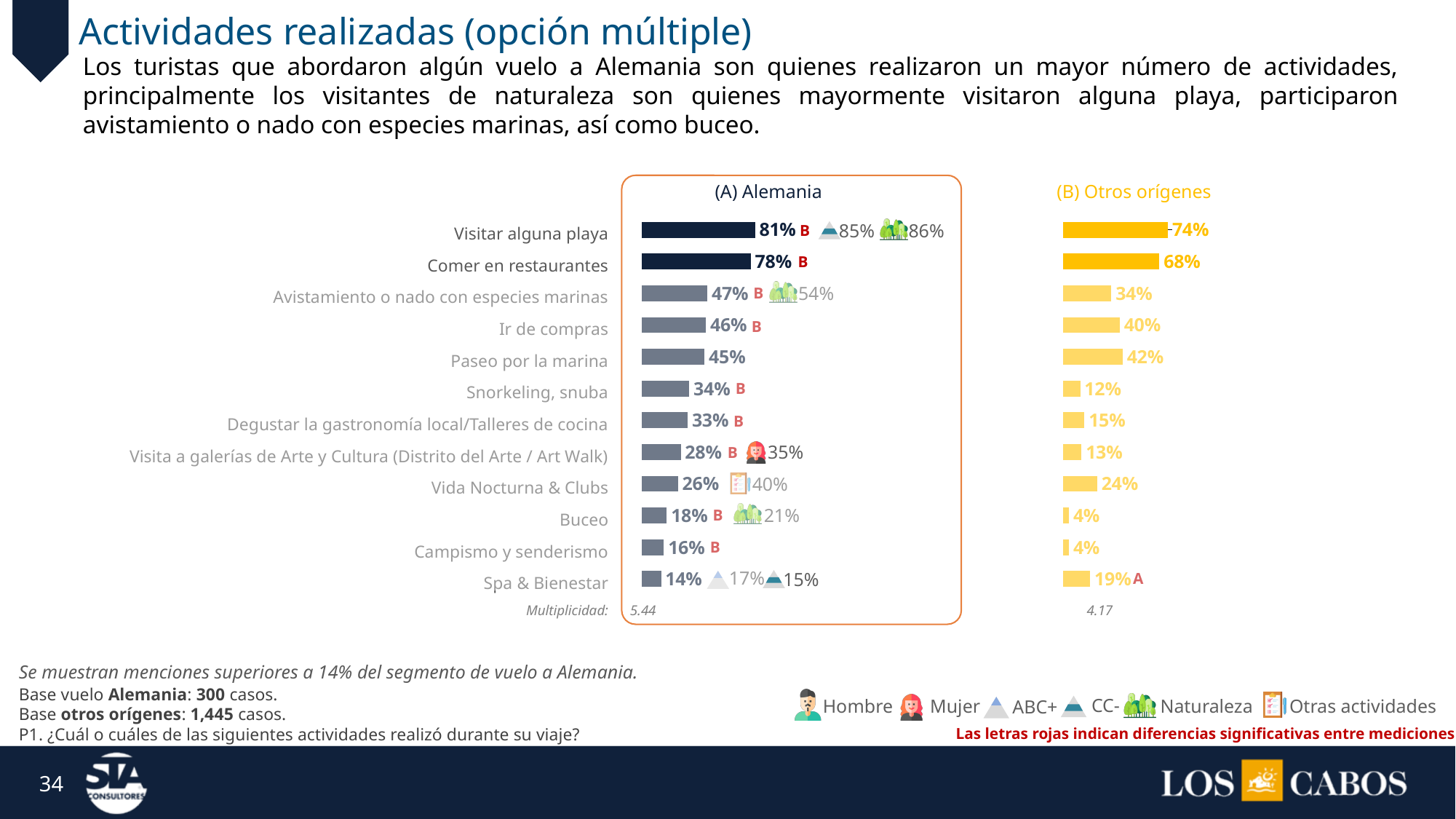
In the (B) Otros orígenes chart, which activity has the lowest percentage? Buceo and Campismo y senderismo (4%) In the (A) Alemania chart, which activity has the highest percentage? Visitar alguna playa What is the difference between the Alemania and Otros orígenes percentages for Snorkeling, snuba? 22 percentage points For Ir de compras, which is larger: the (A) Alemania value or the (B) Otros orígenes value? (A) Alemania In the (B) Otros orígenes chart, what percentage is shown for Comer en restaurantes? 68% How many activities are listed in the (A) Alemania chart? 12 What is the Multiplicidad value shown for (B) Otros orígenes? 4.17 In the (A) Alemania chart, what percentage is shown for Snorkeling, snuba? 34% In the (B) Otros orígenes chart, what percentage is shown for Spa & Bienestar? 19% What is the Multiplicidad value shown for (A) Alemania? 5.44 What kind of chart is used to show the activities for (A) Alemania? Bar chart In the (A) Alemania chart, what percentage is shown for Visitar alguna playa? 81%